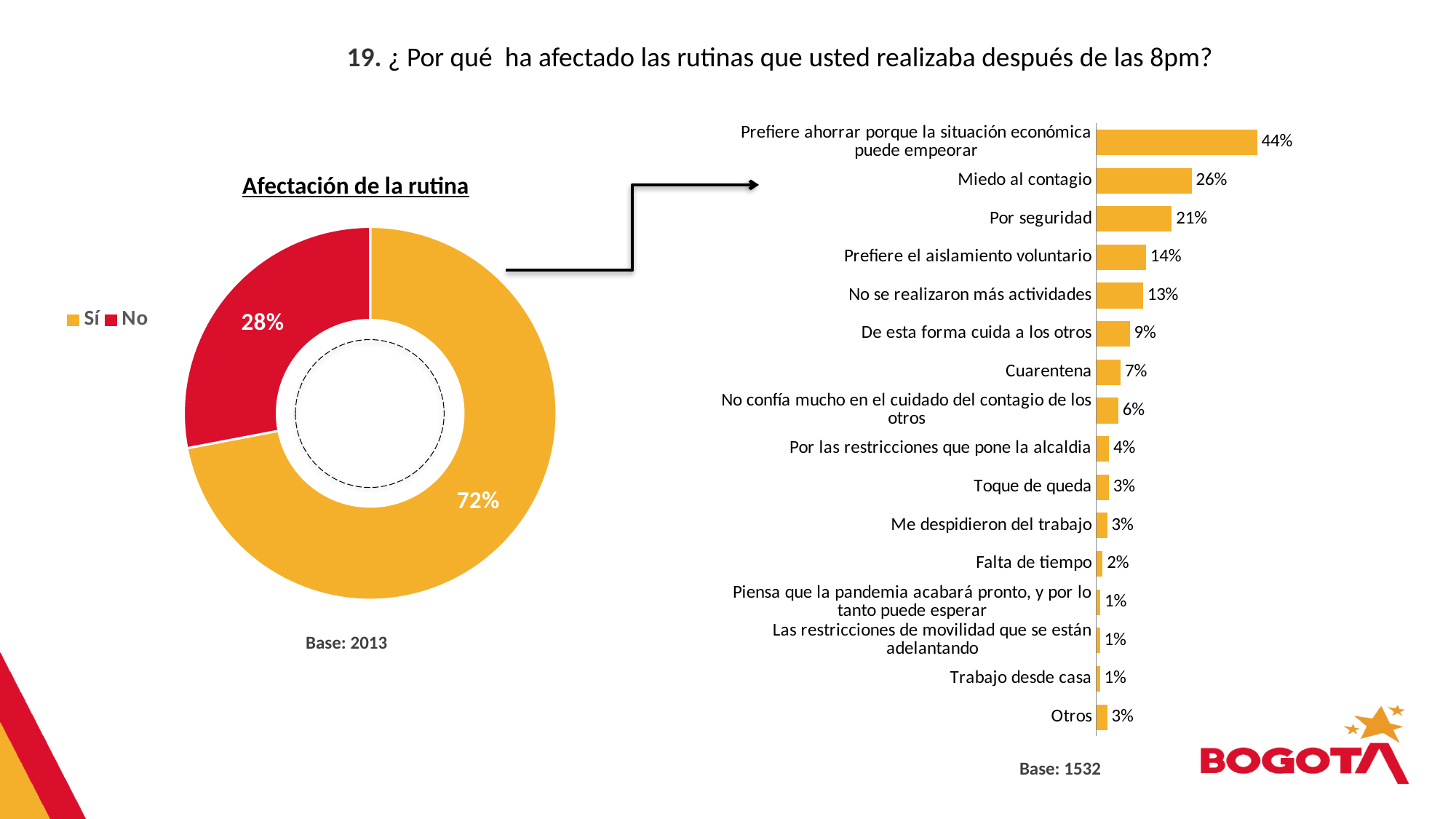
In the 'Afectación de la rutina' donut chart, what colour is the 'No' slice? Red In the bar chart on the right, what is the value for 'Por seguridad'? 21% In the bar chart on the right, what is the difference between 'Prefiere ahorrar porque la situación económica puede empeorar' and 'Miedo al contagio'? 18% In the bar chart on the right, what is the value for 'Toque de queda'? 3% In the 'Afectación de la rutina' donut chart, what percentage answered 'No'? 28% In the bar chart on the right, how many categories are shown? 16 In the bar chart on the right, what is the value for 'Miedo al contagio'? 26% In the bar chart on the right, which is larger: 'Cuarentena' or 'De esta forma cuida a los otros'? De esta forma cuida a los otros In the 'Afectación de la rutina' donut chart, what percentage answered 'Sí'? 72% In the 'Afectación de la rutina' donut chart, how many entries does the legend list? 2 What kind of chart is shown on the right side of the slide? Bar chart In the bar chart on the right, which category has the highest value? Prefiere ahorrar porque la situación económica puede empeorar